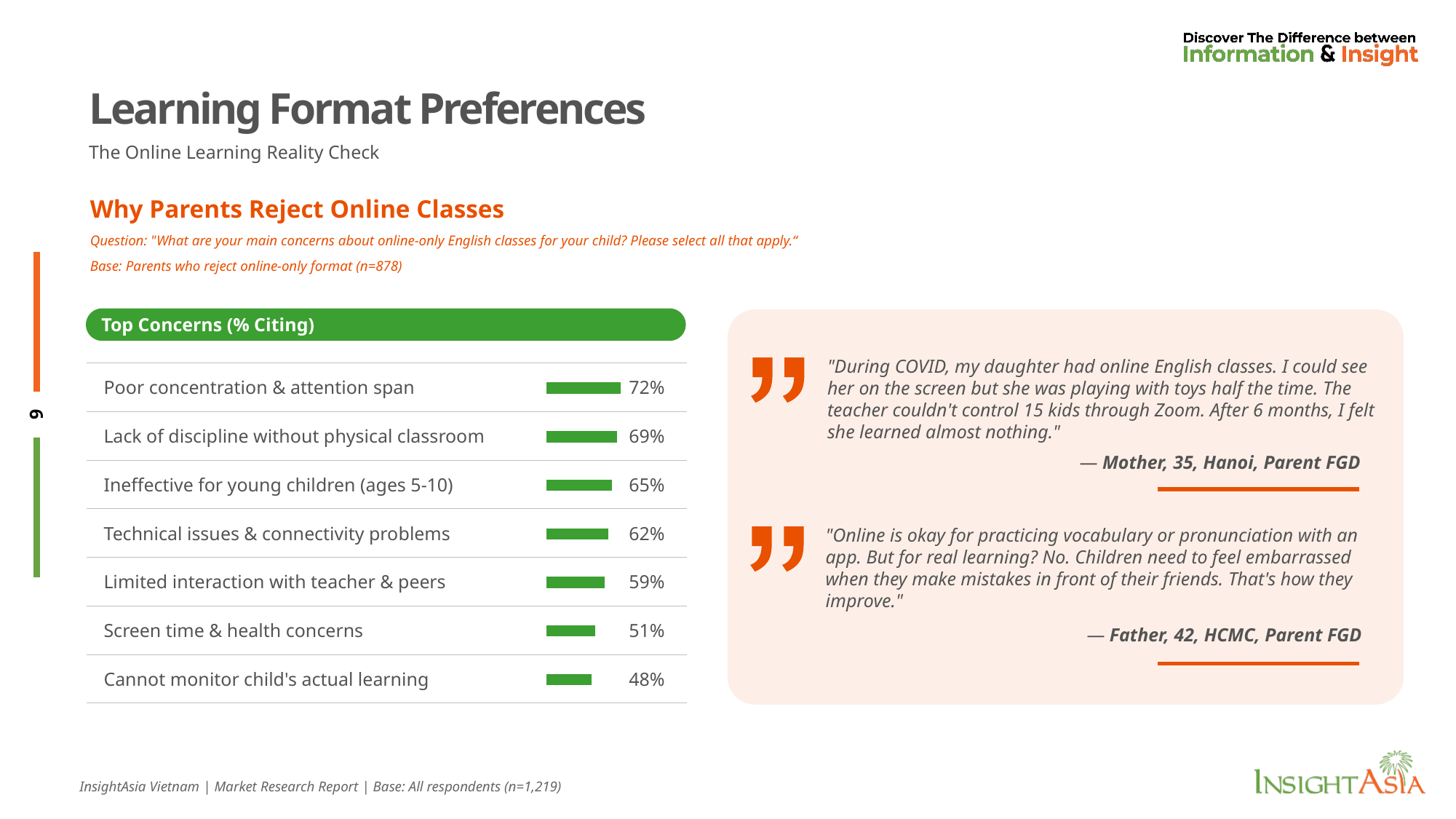
How many concerns are listed in the Top Concerns chart? 7 What colour are the bars in the Top Concerns chart? Green What percentage of parents cite poor concentration & attention span as a concern? 72% Which is cited more often: 'Ineffective for young children (ages 5-10)' or 'Screen time & health concerns'? Ineffective for young children (ages 5-10) What is the difference in percentage points between 'Lack of discipline without physical classroom' and 'Limited interaction with teacher & peers'? 10 percentage points What kind of chart is used to show the top concerns? Bar chart Do the percentages rise or fall going down the list of concerns? Fall Which concern is cited by the lowest percentage of parents? Cannot monitor child's actual learning What percentage cite technical issues & connectivity problems? 62% What percentage cite screen time & health concerns? 51% Which concern is cited by the highest percentage of parents? Poor concentration & attention span What is the title of the chart header above the list of concerns? Top Concerns (% Citing)